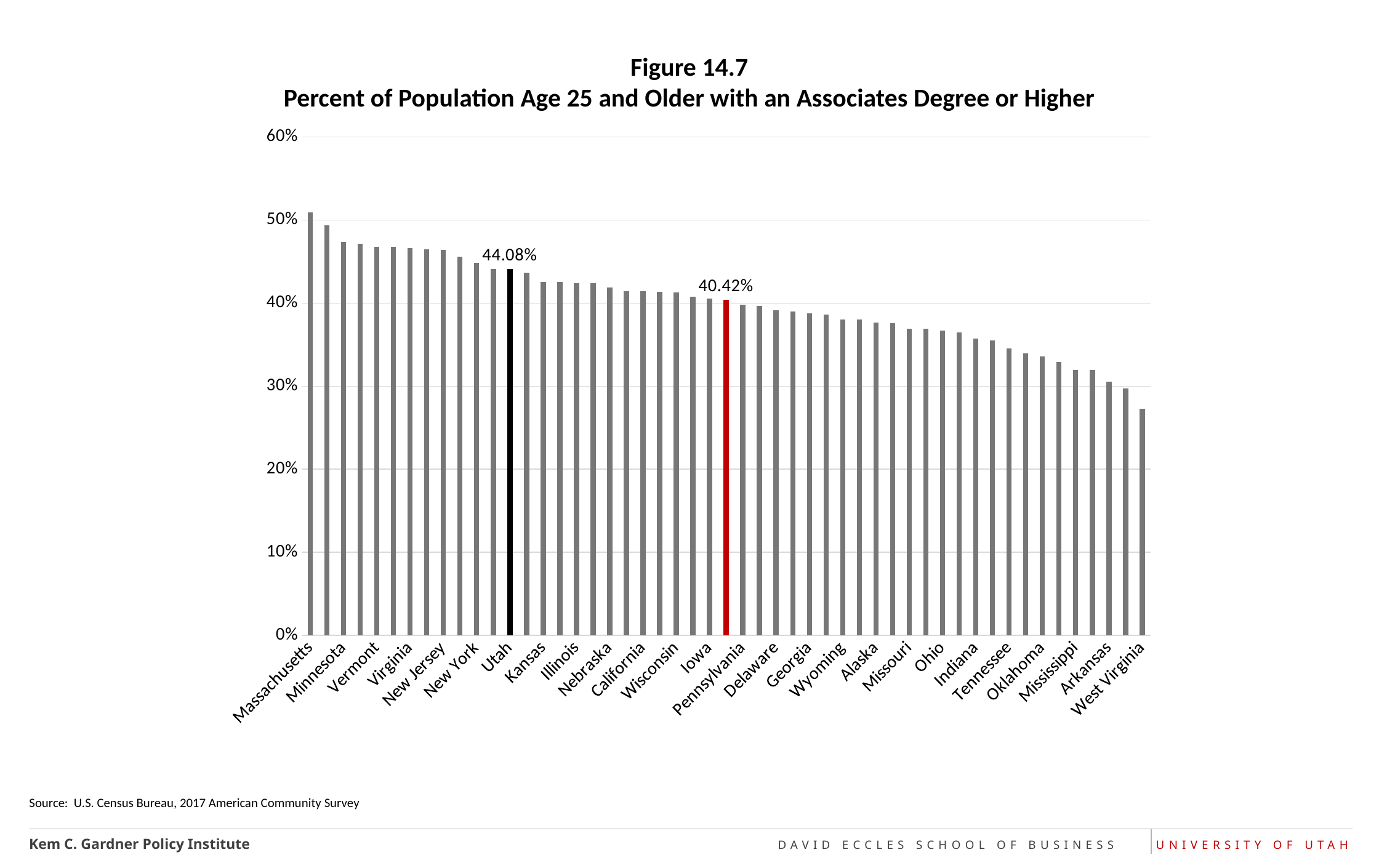
Which state has the highest percentage? Massachusetts Is the value for West Virginia greater or less than 30%? less Which state has the lowest percentage? West Virginia What value is labelled on the red bar? 40.42% What colour is the bar for Utah? black Which is higher, Massachusetts or Minnesota? Massachusetts Is the value for Vermont greater or less than 40%? greater What kind of chart is shown? bar chart Do the values rise or fall from left to right across the chart? fall Is the value for Mississippi greater or less than 40%? less What is the value shown for Utah? 44.08% How many percentage points higher is Utah's value than the value on the red bar? 3.66